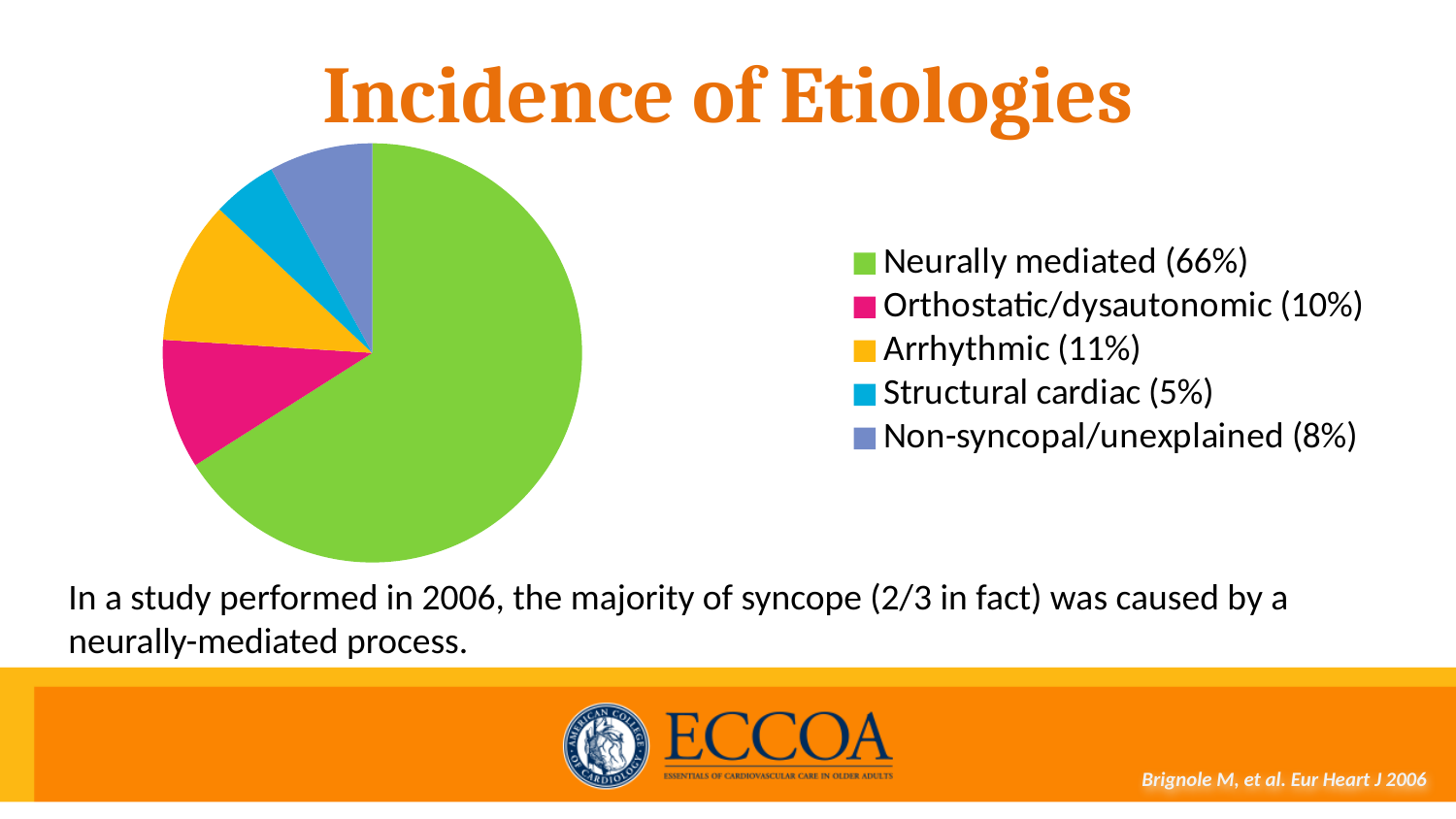
What share of the pie is Structural cardiac? 5% Which is larger, the Arrhythmic share or the Non-syncopal/unexplained share? Arrhythmic How many categories does the pie chart have? 5 What colour is the Orthostatic/dysautonomic slice? pink Which category has the smallest slice of the pie? Structural cardiac What kind of chart is shown on the slide? pie chart What is the difference between the Neurally mediated share and the Orthostatic/dysautonomic share? 56% Which category has the largest slice of the pie? Neurally mediated What share of the pie is Neurally mediated? 66% What share of the pie is Arrhythmic? 11% What is the title of the chart? Incidence of Etiologies